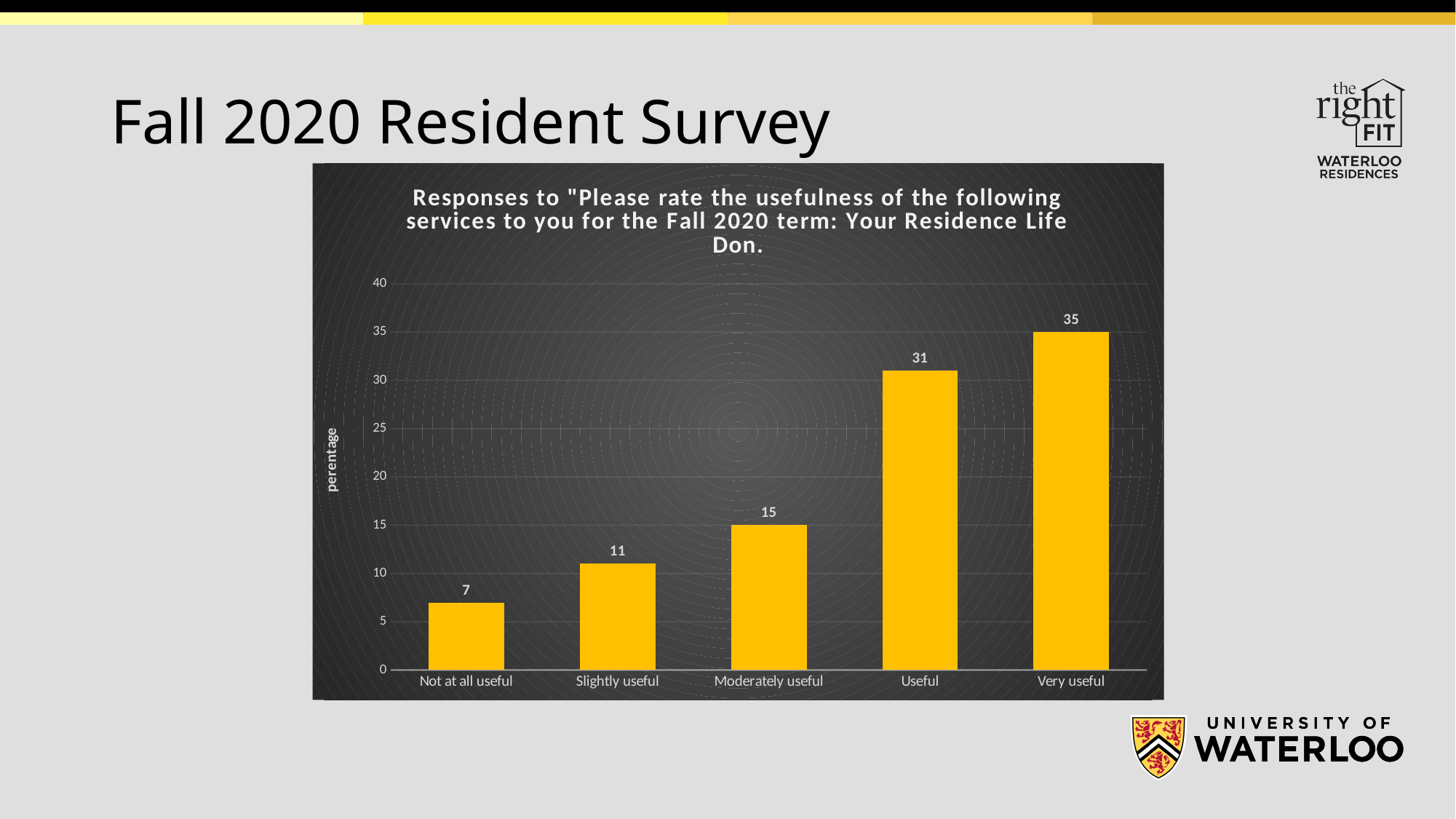
What is the value for "Not at all useful"? 7 What is the value for "Very useful"? 35 Do the values rise or fall from left to right along the x axis? rise What is the difference between the values for "Useful" and "Slightly useful"? 20 What is the value for "Moderately useful"? 15 Which is larger, the value for "Moderately useful" or the value for "Slightly useful"? Moderately useful What is the label on the vertical axis of the chart? perentage Which category has the highest value? Very useful What kind of chart is shown on the slide? bar chart Which category has the lowest value? Not at all useful Is the value for "Useful" greater or less than 30? greater How many categories are shown on the x axis? 5